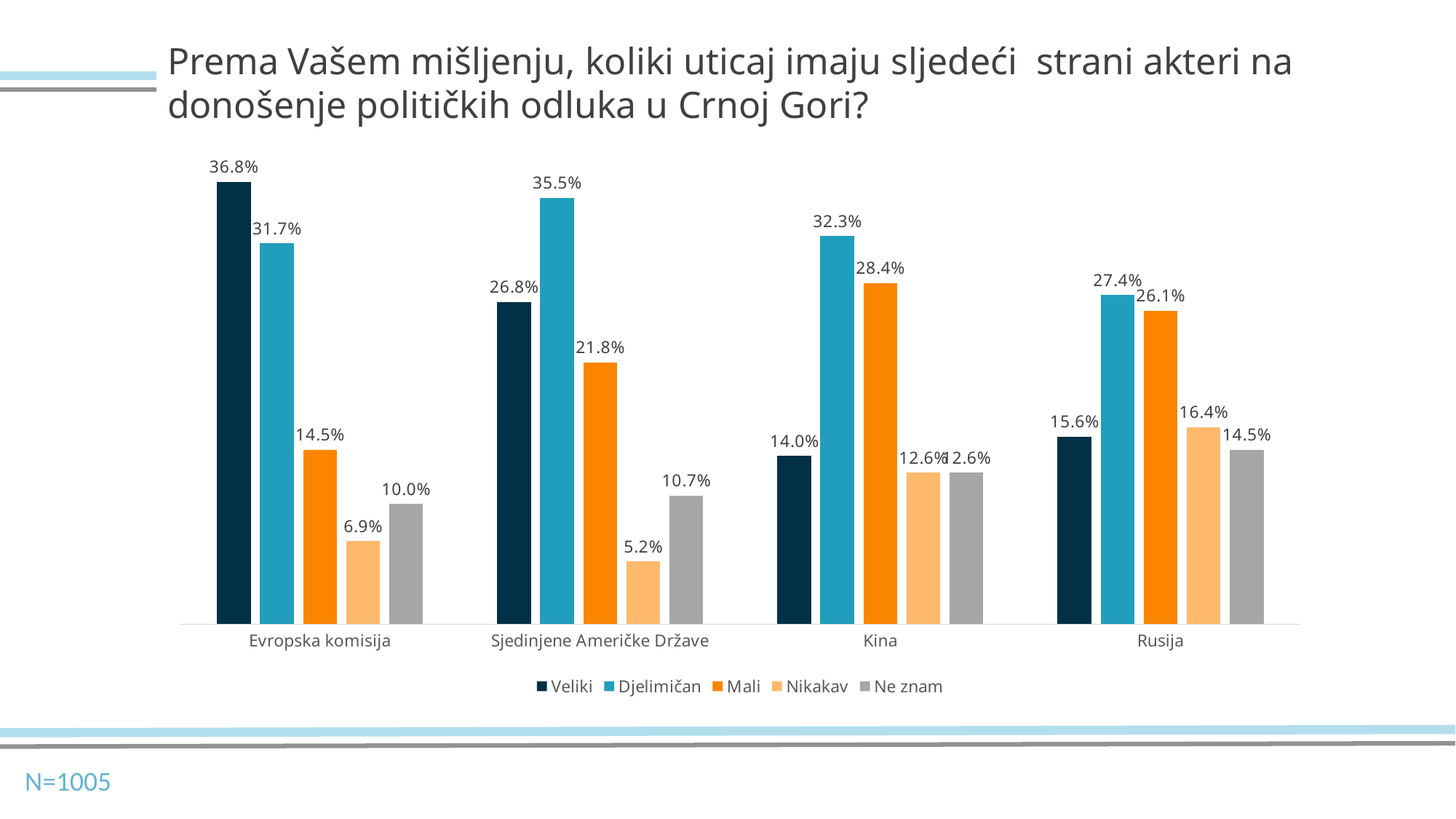
Which category has the lowest Nikakav value? Sjedinjene Američke Države What kind of chart is shown on the slide? Bar chart Which is larger for Rusija: the Djelimičan value or the Mali value? Djelimičan What is the value for Djelimičan for Sjedinjene Američke Države? 35.5% Which category has the highest Veliki value? Evropska komisija What is the value for Mali for Kina? 28.4% What is the difference between the Veliki and Djelimičan values for Evropska komisija? 5.1% How many series does the legend list? 5 What is the value for Veliki for Evropska komisija? 36.8% How many categories are shown on the x axis? 4 What is the value for Nikakav for Rusija? 16.4% What is the sample size shown on the slide? N=1005